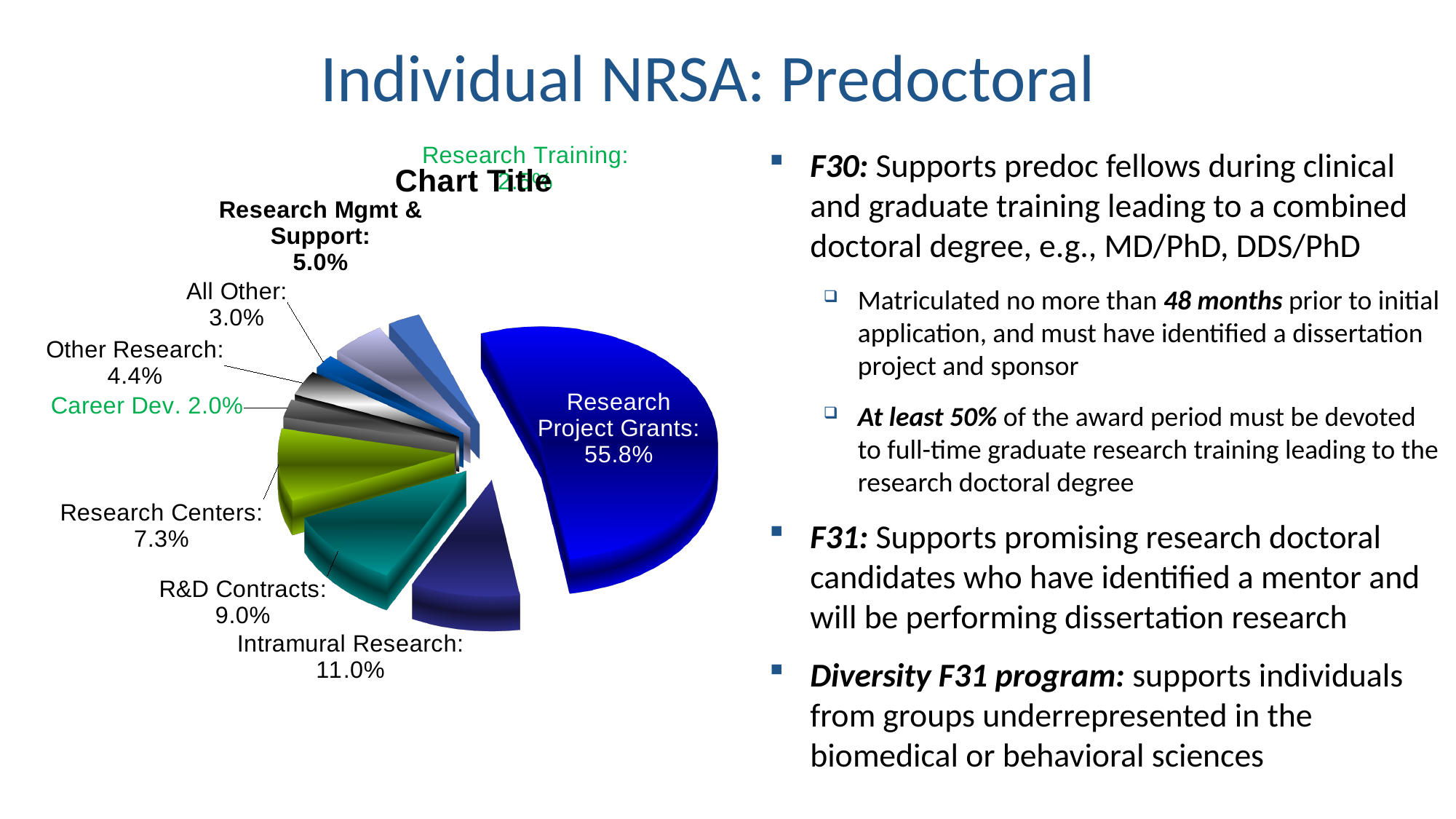
What is the value shown for Research Mgmt & Support? 5.0% What is the title printed on the chart? Chart Title What is the value shown for Research Centers? 7.3% What is the value shown for R&D Contracts? 9.0% How many slices does the pie chart have? 9 What share of the pie does Research Project Grants represent? 55.8% What is the difference between the values for Intramural Research and R&D Contracts? 2.0% What is the value shown for Career Dev.? 2.0% What kind of chart is shown on the slide? pie chart Which category has the largest slice of the pie? Research Project Grants What is the value shown for Intramural Research? 11.0% Which is larger, Other Research or All Other? Other Research